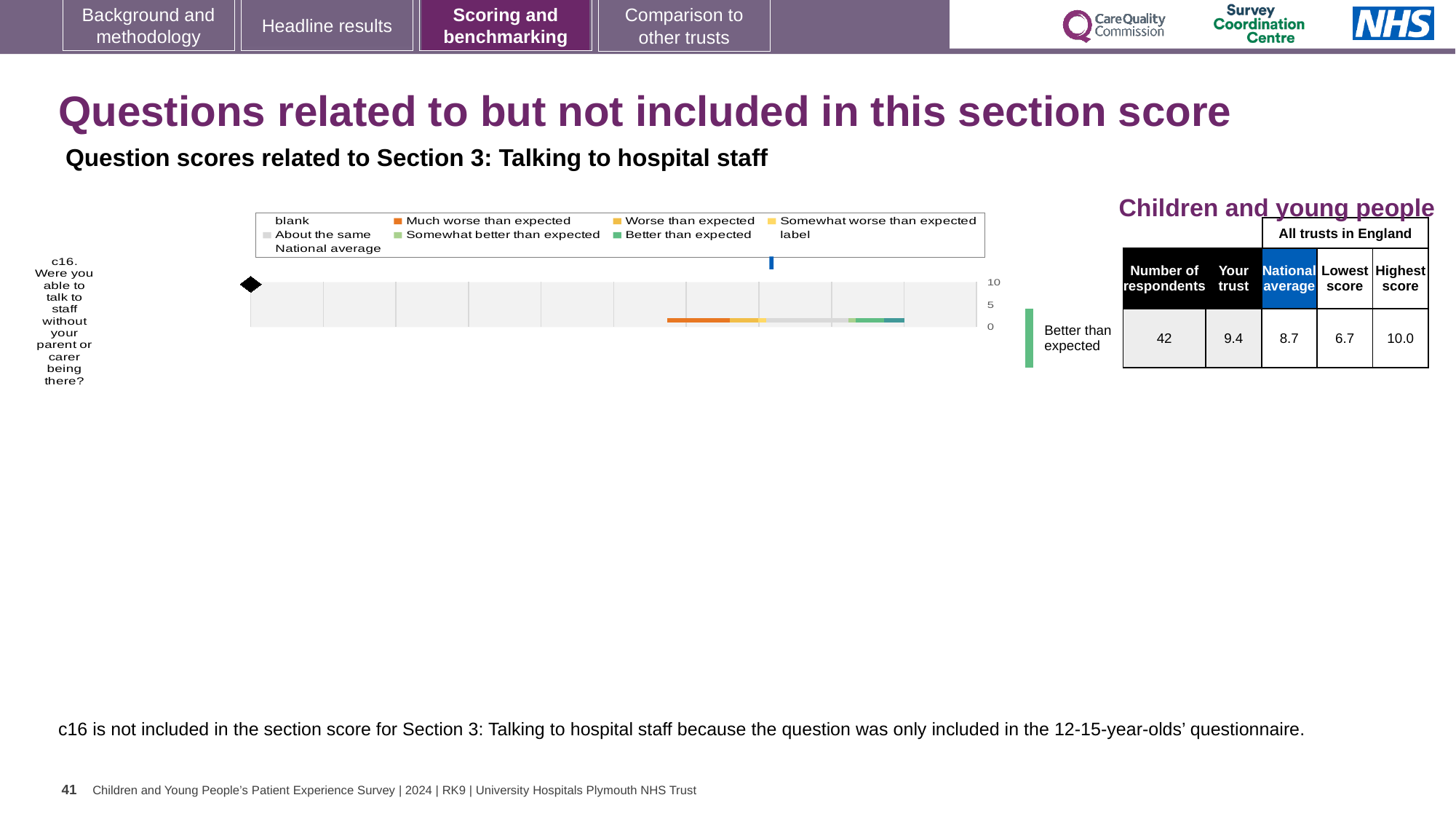
What is the highest tick value shown on the chart's axis? 10 In the table beside the chart, what is the 'Your trust' score for c16? 9.4 Is the 'Your trust' score for c16 higher or lower than the National average? higher Which legend entry is shown in orange on the chart? Much worse than expected In the table beside the chart, what is the Lowest score across all trusts in England for c16? 6.7 What kind of chart is shown for question c16? bar chart What rating label is shown next to the chart for question c16? Better than expected In the table beside the chart, what is the Highest score across all trusts in England for c16? 10.0 In the table beside the chart, how many respondents answered c16? 42 In the table beside the chart, what is the National average score for c16? 8.7 How many questions (categories) are plotted on the chart? 1 What is the difference between the 'Your trust' score and the National average for c16? 0.7